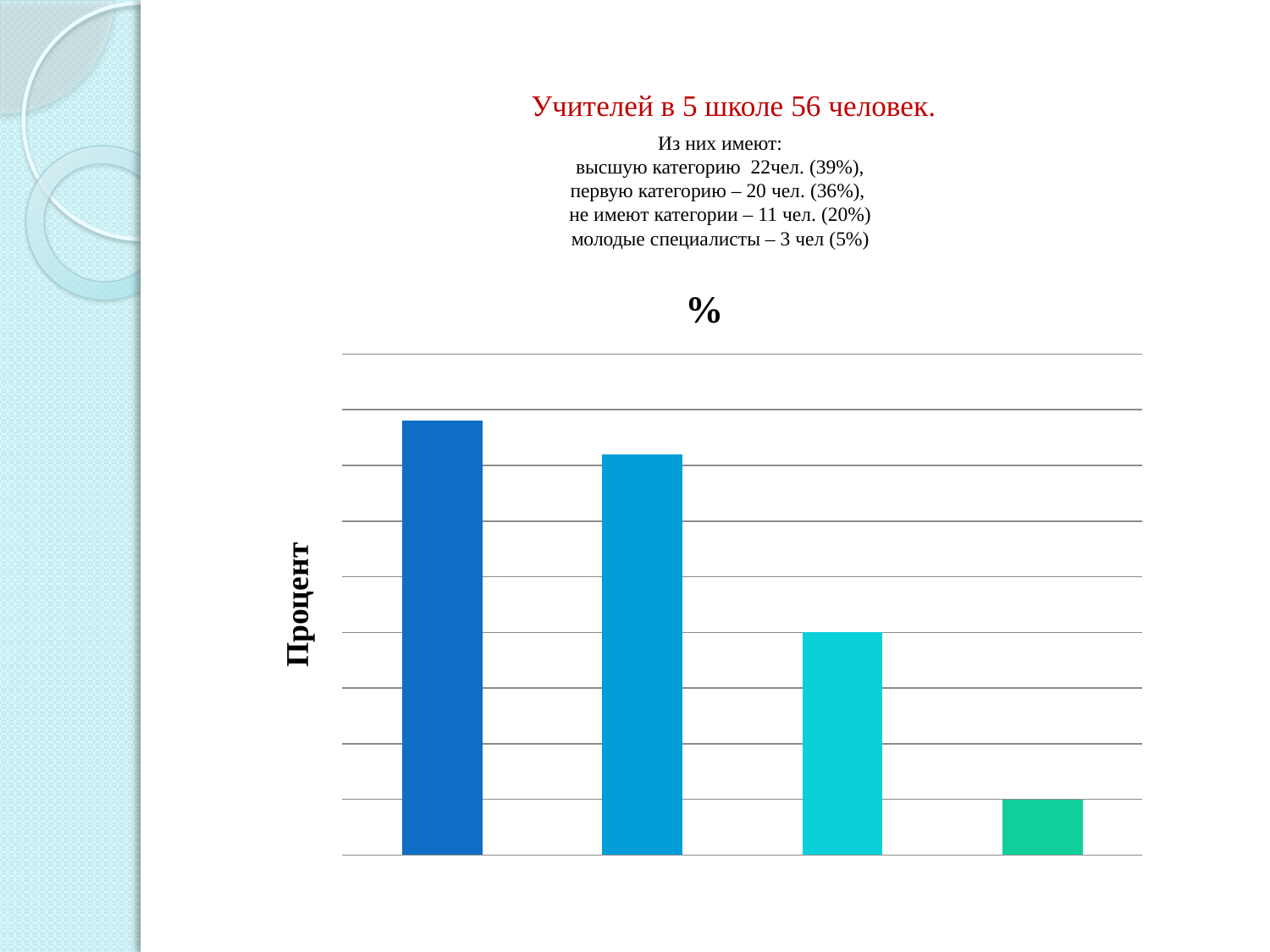
What is the label on the vertical axis of the chart? Процент What is the title of the chart? % Which bar is the tallest in the chart? the leftmost (first) bar What kind of chart is shown on the slide? bar chart How many bars does the chart contain? 4 Which is taller, the first bar or the second bar? the first bar Which is taller, the third bar or the fourth bar? the third bar Which bar is the shortest in the chart? the rightmost (fourth) bar Do the bar heights rise or fall from left to right across the chart? fall